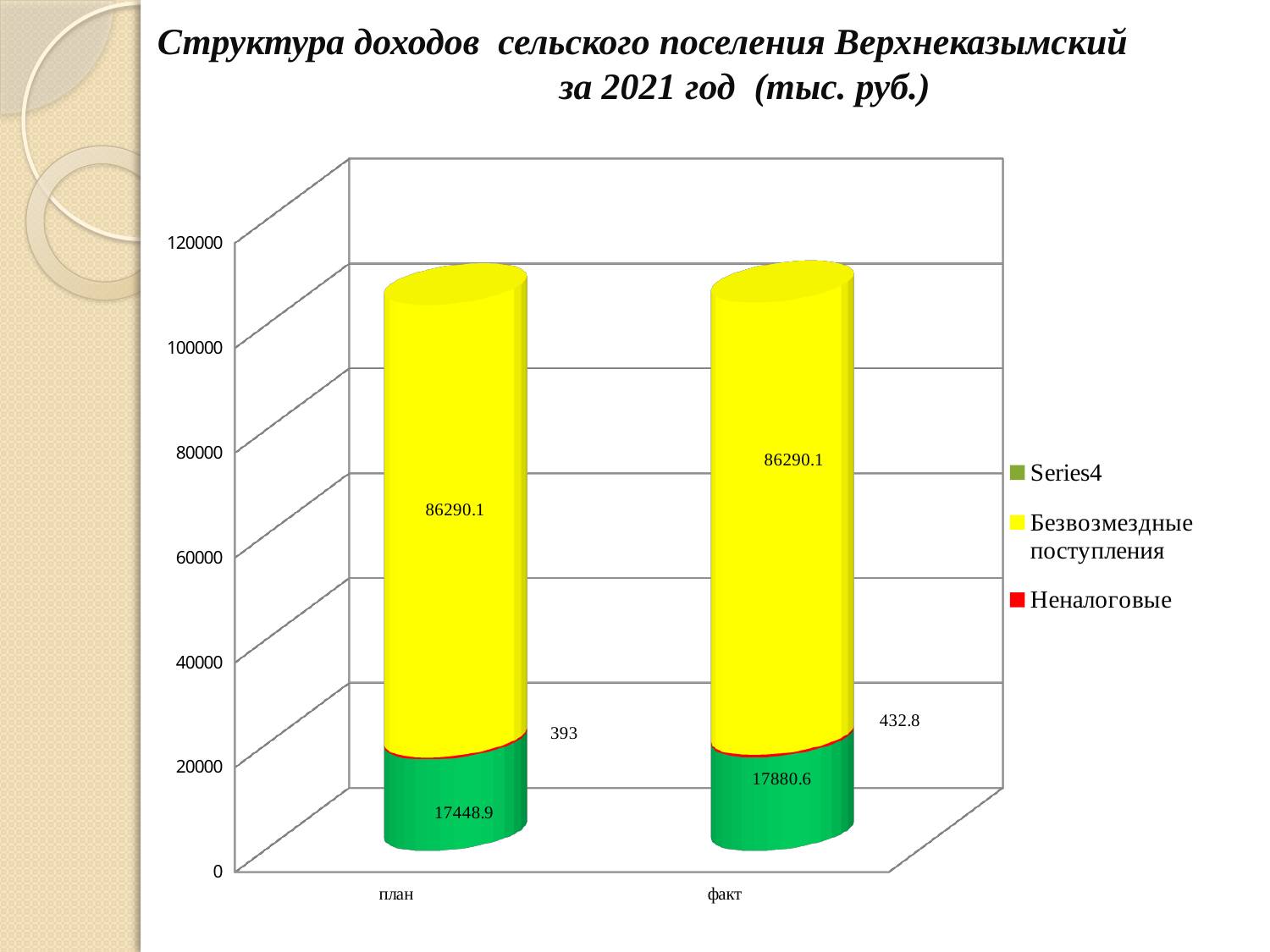
What is the value of Series4 for план? 17448.9 What is the total of the stacked bar for факт? 104603.5 How many categories are shown on the x axis? 2 Which is larger, the Series4 value for план or for факт? факт What is the value of Series4 for факт? 17880.6 What is the value of Неналоговые for план? 393 What is the difference between the Series4 values for факт and план? 431.7 What kind of chart is shown on the slide? Stacked bar chart What is the value of Безвозмездные поступления for план? 86290.1 What is the difference between the Неналоговые values for факт and план? 39.8 How many series does the legend list? 3 What is the value of Неналоговые for факт? 432.8